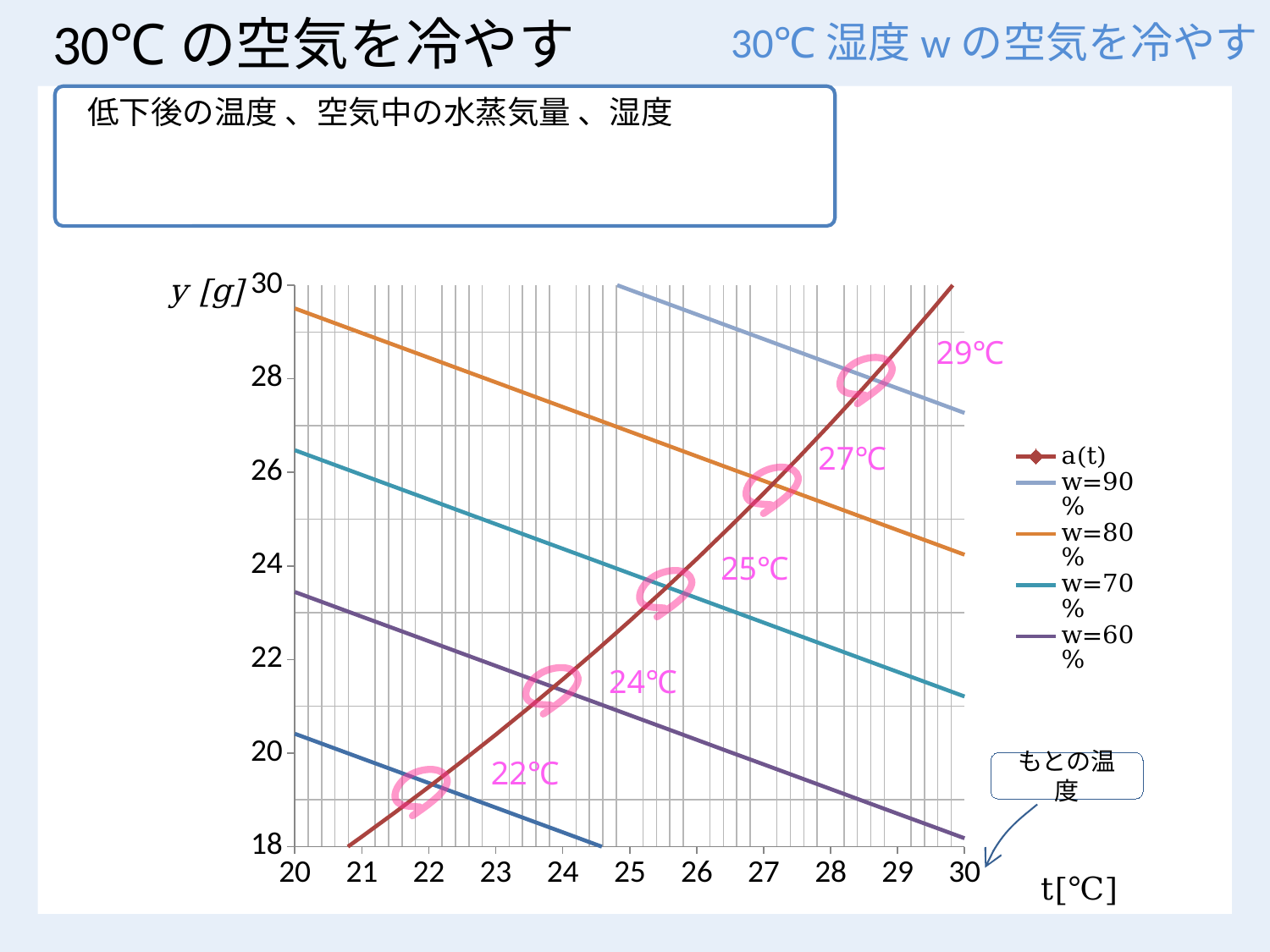
Does the a(t) series rise or fall as t increases from 20 to 30? rises Which series is drawn in red with diamond markers according to the legend? a(t) What is the label of the horizontal axis? t[℃] Is the value of the w=80% line at t=20 greater or less than 29? greater Is the value of the w=60% line at t=30 greater or less than 19? less Is the value of a(t) at t=28 greater or less than 26? greater What kind of chart is shown on the slide? line chart At t=25, which line has the higher value, w=80% or w=70%? w=80% How many pink temperature annotations (circled intersection points) are marked on the chart? 5 Does the w=80% line rise or fall as t increases from 20 to 30? falls How many series does the legend list? 5